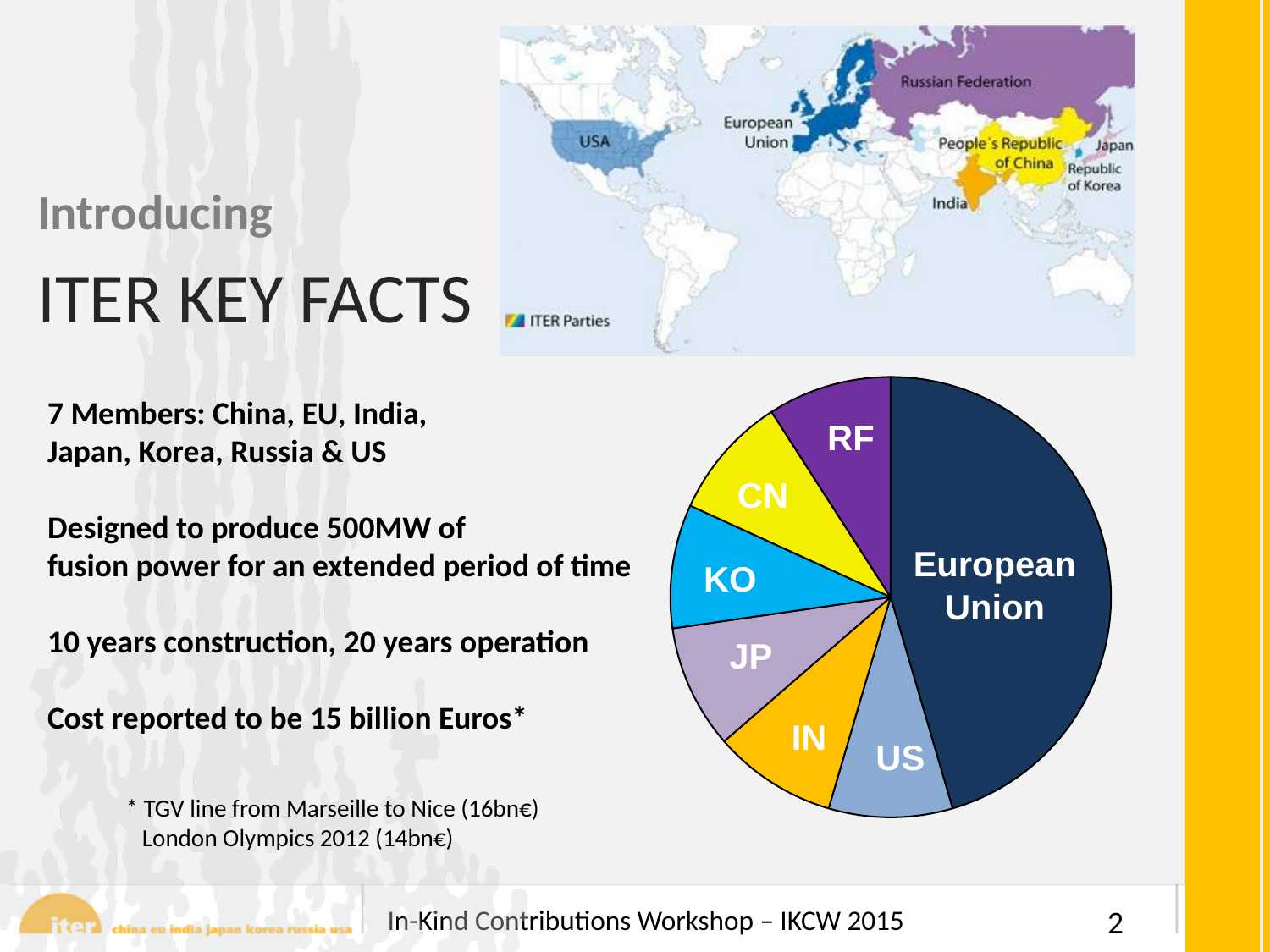
Which slice lies between the IN slice and the KO slice in the pie chart? JP Does the European Union slice take up more or less than half of the pie chart? less What colour is the RF slice in the pie chart? purple Which is larger in the pie chart, the CN slice or the European Union slice? European Union What kind of chart is shown on the slide? pie chart Which is larger in the pie chart, the European Union slice or the US slice? European Union Which is larger in the pie chart, the European Union slice or the RF slice? European Union Which slice of the pie chart is the largest? European Union How many slices does the pie chart have? 7 Which slice of the pie chart is coloured dark navy blue? European Union